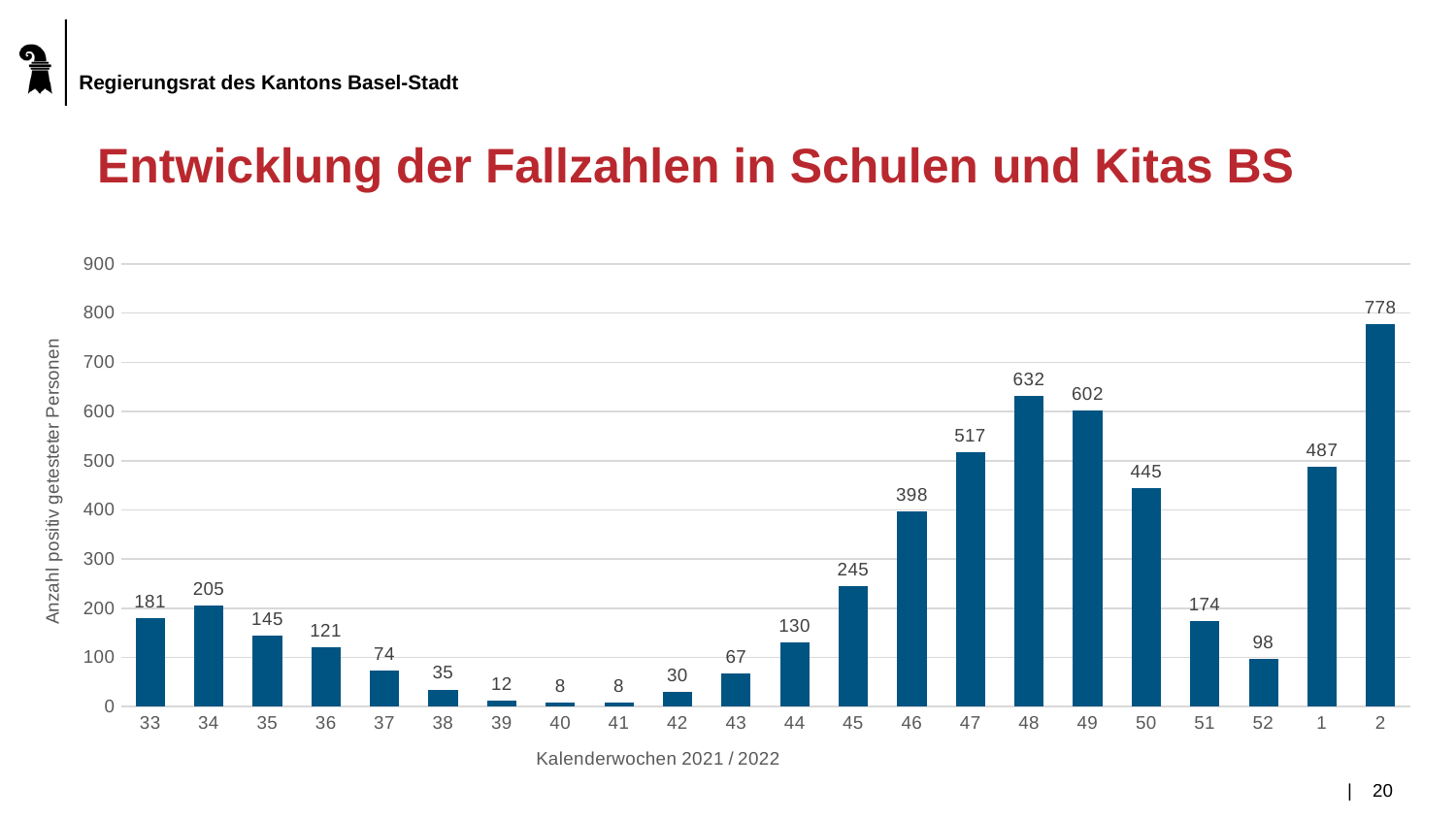
What is the difference between the values for calendar week 47 and calendar week 46? 119 Which is larger, the value for calendar week 49 or calendar week 50? 49 What is the label of the y axis? Anzahl positiv getesteter Personen How many calendar weeks are shown on the x axis? 22 What is the value for calendar week 1 (2022)? 487 What is the difference between the values for calendar week 2 and calendar week 48? 146 What is the value for calendar week 48? 632 What is the lowest value shown in the chart? 8 Is the value for calendar week 45 greater or less than 200? greater What kind of chart is shown on the slide? bar chart Which calendar week has the highest value? 2 What is the value for calendar week 38? 35